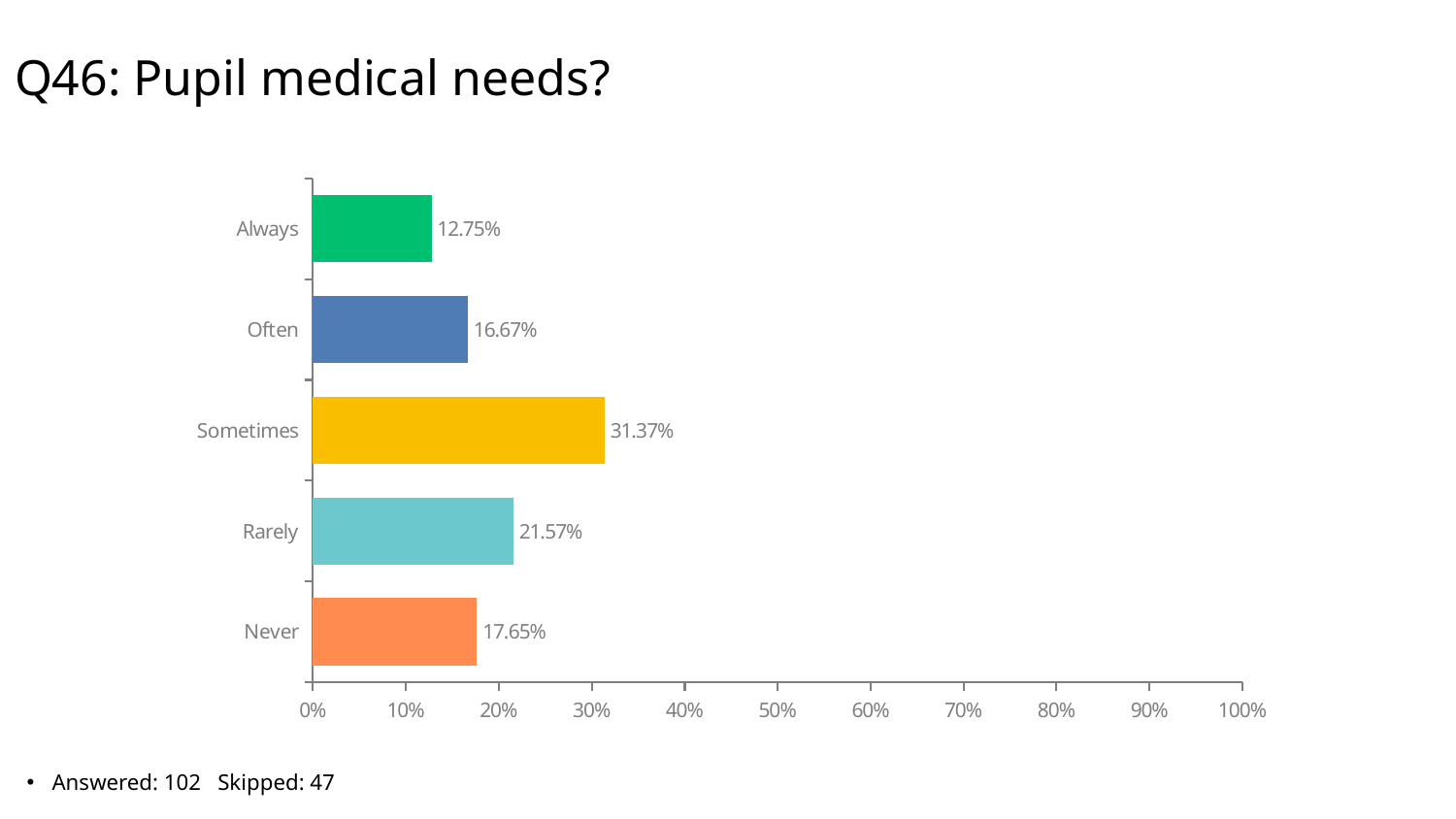
What is the difference between the values for Never and Often? 0.98% What is the value for Sometimes? 31.37% What is the value for Always? 12.75% Which is larger, the value for Rarely or the value for Often? Rarely Which category has the lowest value? Always What colour is the bar for Sometimes? yellow Which category has the highest value? Sometimes How many categories are shown in the chart? 5 What kind of chart is shown on the slide? bar chart Is the value for Sometimes greater or less than 30%? greater What is the difference between the values for Sometimes and Rarely? 9.80% What is the value for Never? 17.65%